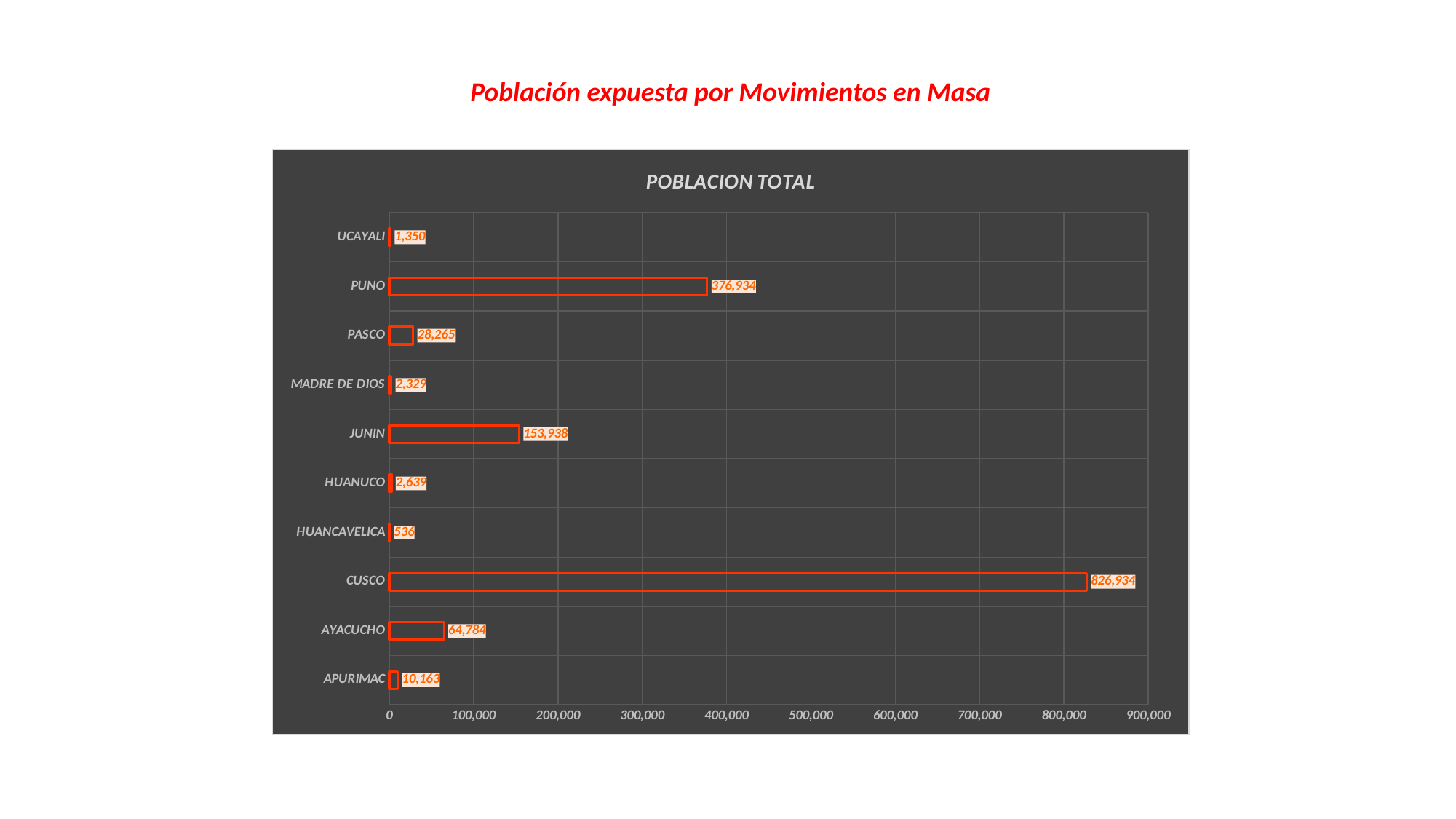
What is the difference between the values for CUSCO and PUNO? 450,000 What is the title of the chart? POBLACION TOTAL What is the difference between the values for AYACUCHO and PASCO? 36,519 Which is larger, the value for HUANUCO or the value for MADRE DE DIOS? HUANUCO How many categories are shown in the chart? 10 What is the value for APURIMAC? 10,163 What is the value for HUANCAVELICA? 536 Which category has the highest value? CUSCO What is the value for CUSCO? 826,934 What kind of chart is shown on the slide? Bar chart Which category has the lowest value? HUANCAVELICA What is the value for JUNIN? 153,938